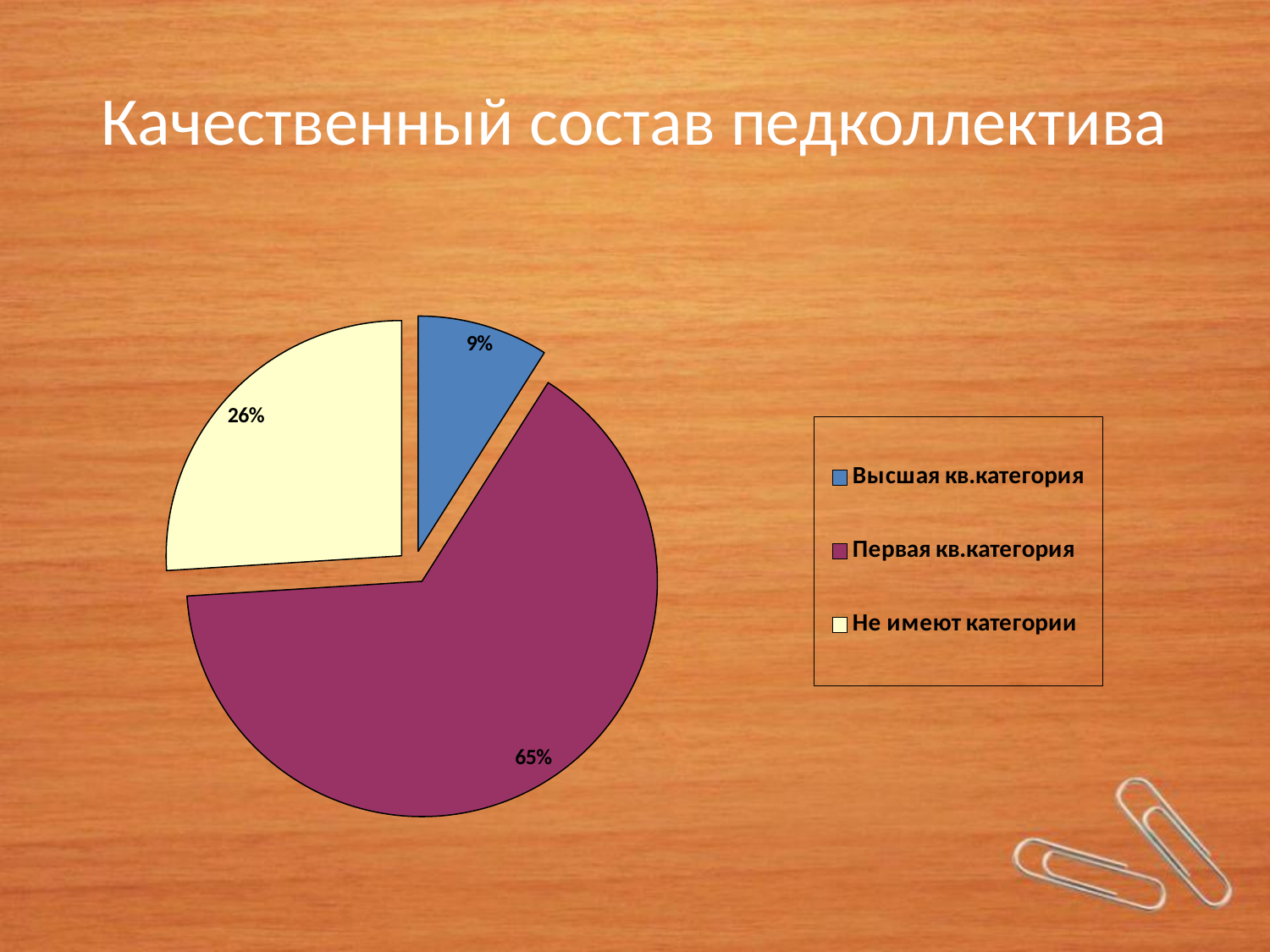
Which category has the smallest slice of the pie? Высшая кв.категория What share of the pie does "Первая кв.категория" have? 65% Which category has the largest slice of the pie? Первая кв.категория What share of the pie does "Высшая кв.категория" have? 9% What kind of chart is shown on the slide? Pie chart What is the difference in percentage points between "Первая кв.категория" and "Не имеют категории"? 39 What is the title of the slide? Качественный состав педколлектива What share of the pie does "Не имеют категории" have? 26% How many categories does the pie chart show? 3 What is the difference in percentage points between "Не имеют категории" and "Высшая кв.категория"? 17 Which is larger: the slice for "Не имеют категории" or the slice for "Высшая кв.категория"? Не имеют категории What colour is the slice for "Первая кв.категория"? Purple